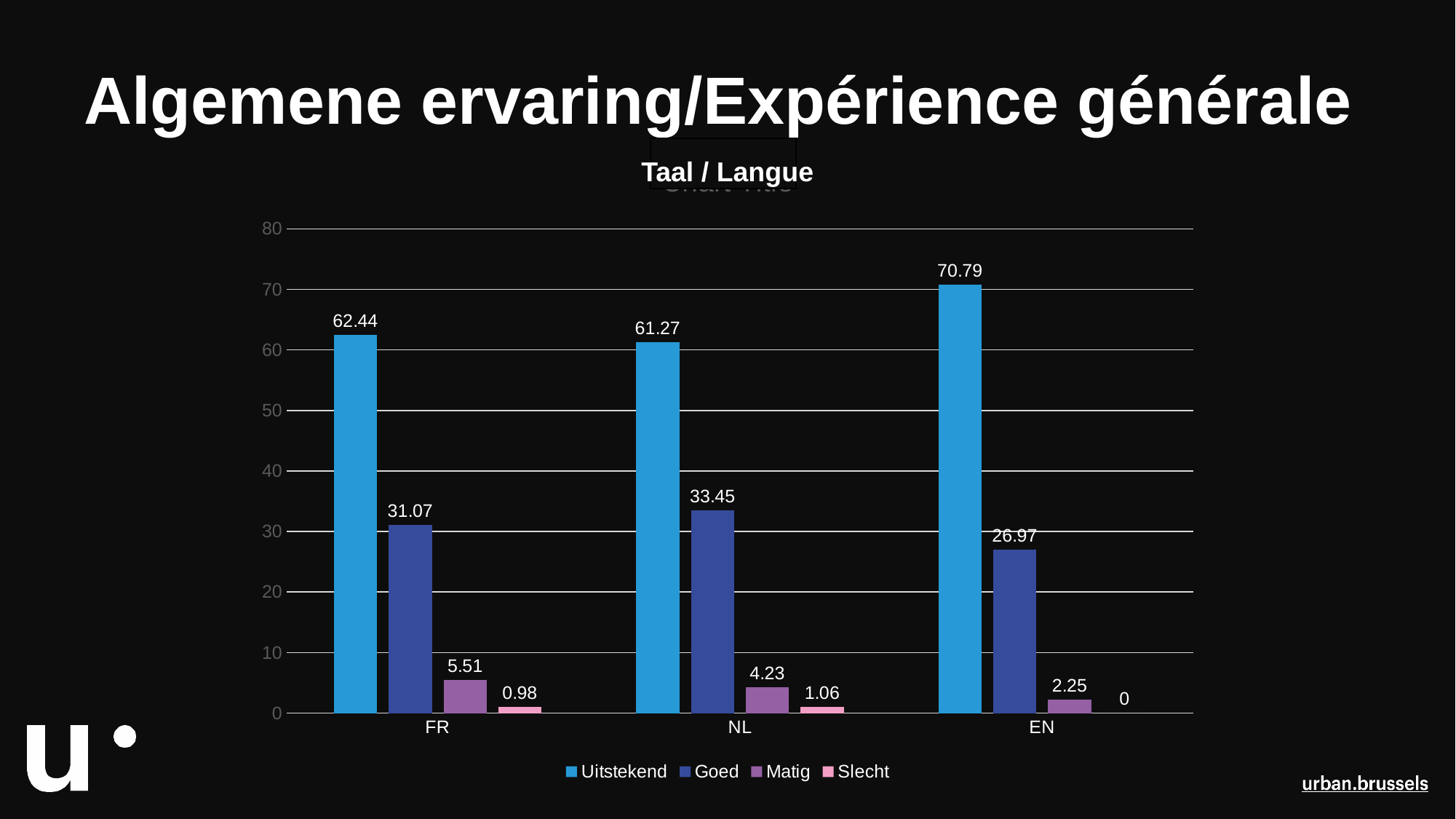
What is the value for Goed in the NL category? 33.45 What kind of chart is shown on the slide? Bar chart What is the value for Slecht in the FR category? 0.98 Which category has the highest value for Uitstekend? EN What is the value for Matig in the EN category? 2.25 Which category has the lowest value for Slecht? EN Which is larger, the Goed value for FR or the Goed value for NL? NL How many categories are shown on the x axis? 3 What is the value for Uitstekend in the EN category? 70.79 How many series does the legend list? 4 What is the difference between the Uitstekend values for EN and FR? 8.35 What is the title shown above the chart? Taal / Langue